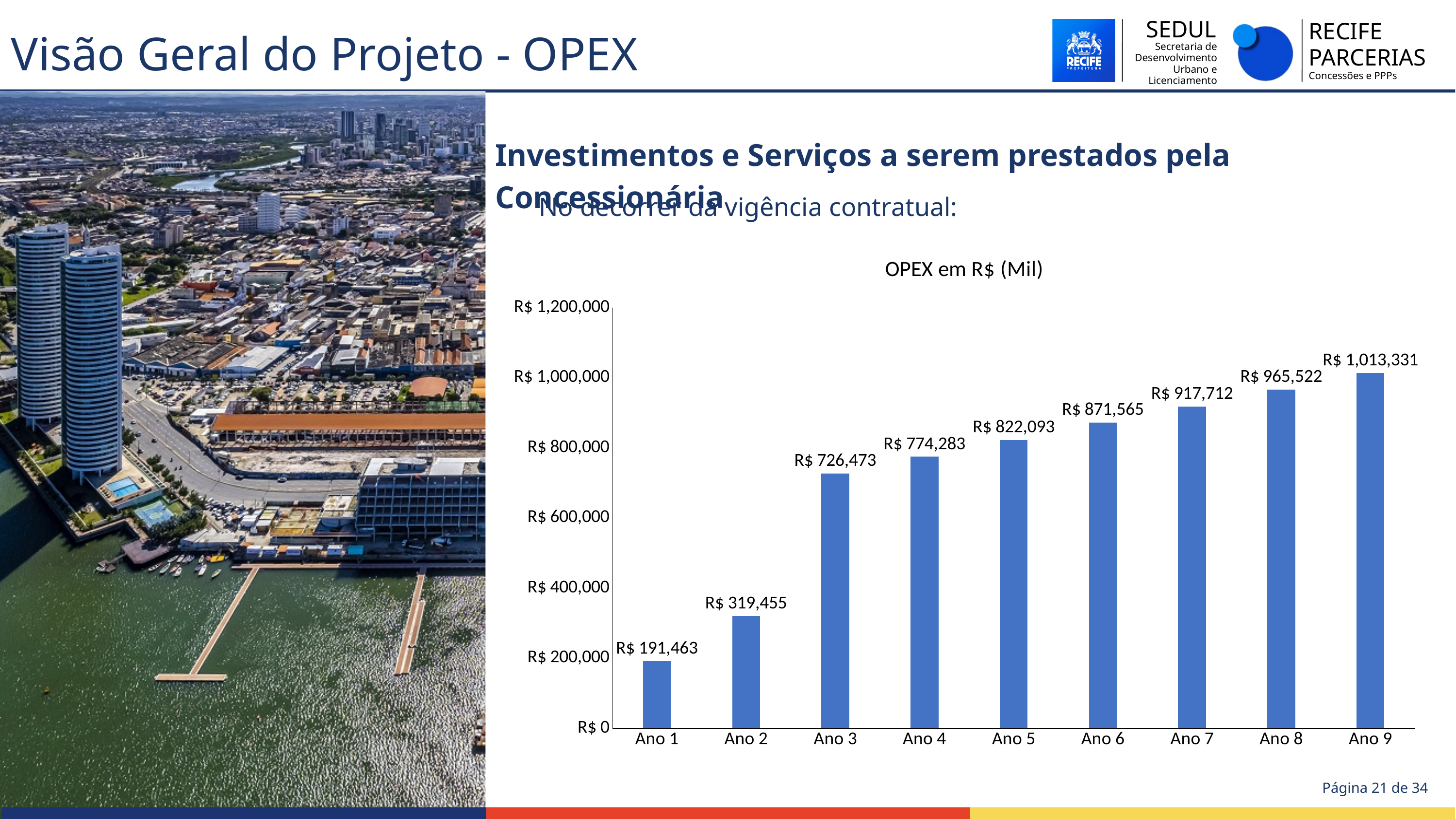
Which is larger, the OPEX value for Ano 5 or for Ano 4? Ano 5 What is the OPEX value for Ano 3? R$ 726,473 What is the title of the chart? OPEX em R$ (Mil) Is the OPEX value for Ano 8 greater or less than R$ 1,000,000? less What is the difference between the OPEX values for Ano 9 and Ano 8? R$ 47,809 How many years are shown on the x axis of the chart? 9 What is the OPEX value for Ano 7? R$ 917,712 What is the difference between the OPEX values for Ano 2 and Ano 1? R$ 127,992 Which year has the lowest OPEX value? Ano 1 Which year has the highest OPEX value? Ano 9 Do the OPEX values rise or fall from Ano 1 to Ano 9? rise What kind of chart is shown on the slide? bar chart